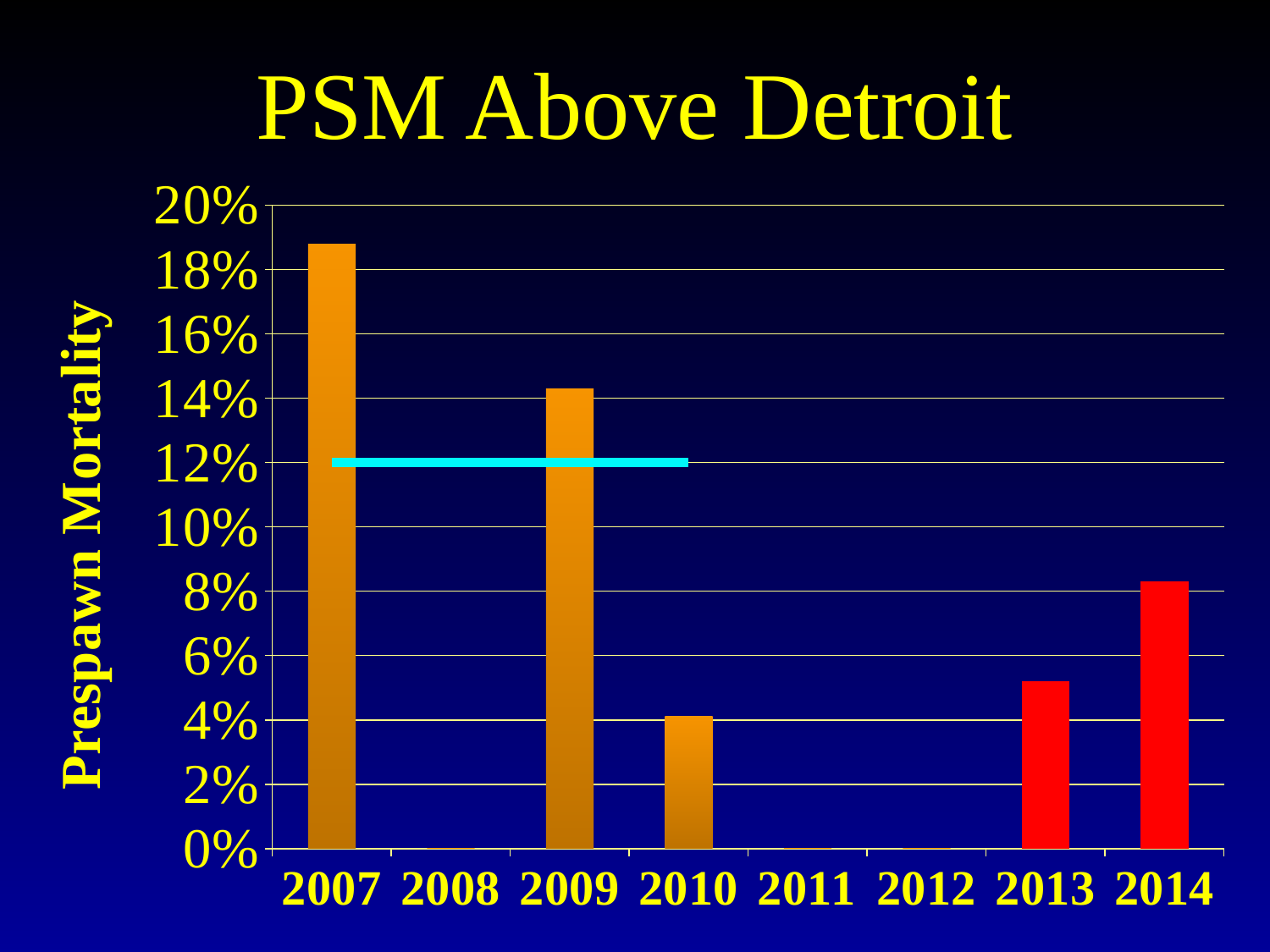
How many years are shown on the x axis? 8 Is the value for 2007 greater or less than 18%? greater Do the values rise or fall from 2007 to 2010? fall What kind of chart is shown on the slide? bar chart Is the value for 2014 greater or less than 6%? greater Is the value for 2010 greater or less than 6%? less What is the title of the chart? PSM Above Detroit Which year has the highest prespawn mortality? 2007 Which year has the larger prespawn mortality, 2013 or 2014? 2014 What is the label on the vertical axis? Prespawn Mortality Which year has the larger prespawn mortality, 2007 or 2009? 2007